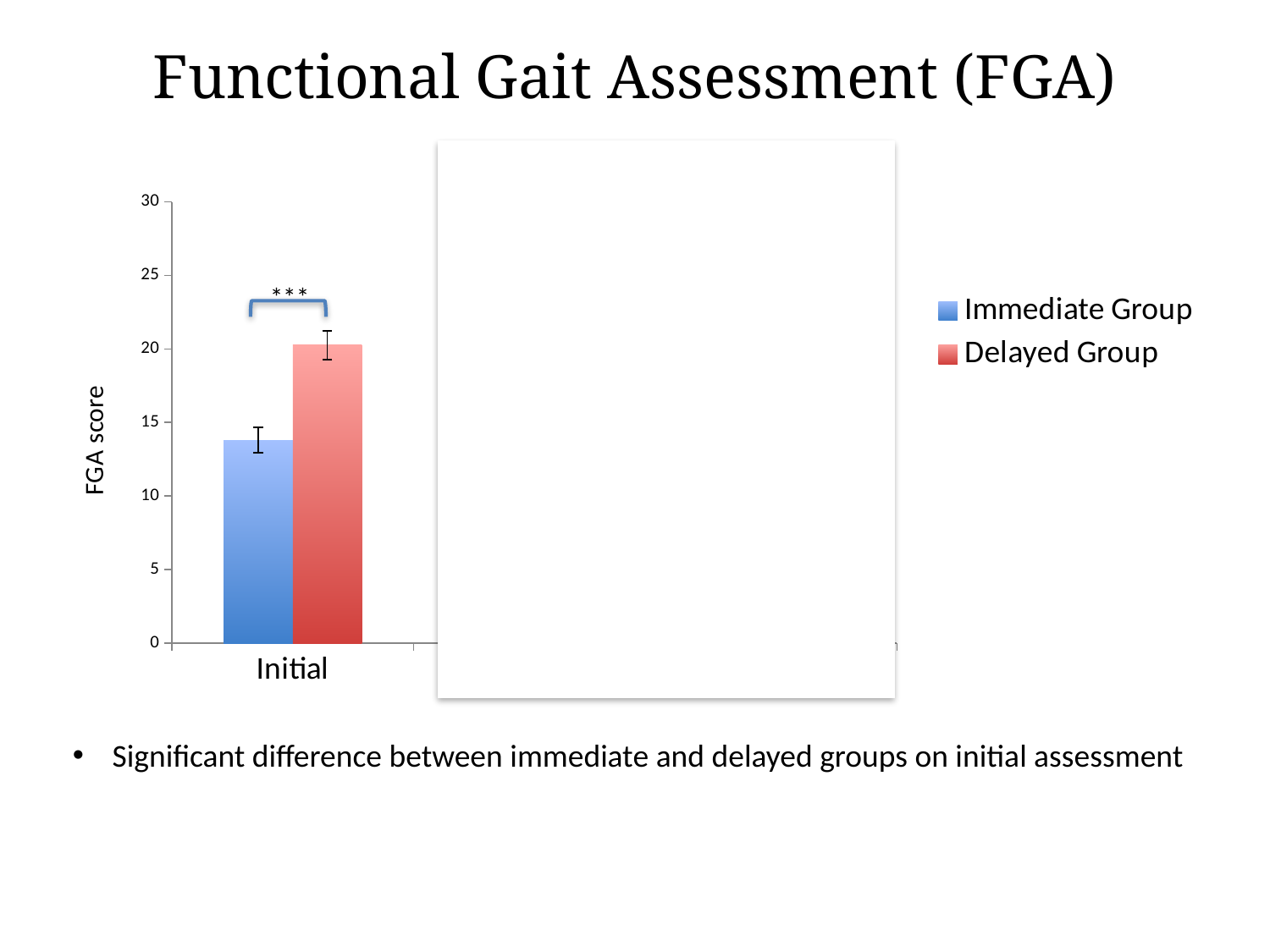
Is the Initial FGA score for the Immediate Group greater or less than 15? less What kind of chart is shown on the slide? bar chart Which group has the higher FGA score at the Initial assessment? Delayed Group Which colour represents the Delayed Group in the chart? red How many series does the legend list? 2 What is the label on the vertical axis of the chart? FGA score Is the Initial FGA score for the Immediate Group greater or less than 10? greater What is the maximum value shown on the vertical axis? 30 Which group has the lower FGA score at the Initial assessment? Immediate Group Is the Initial FGA score for the Delayed Group greater or less than 25? less